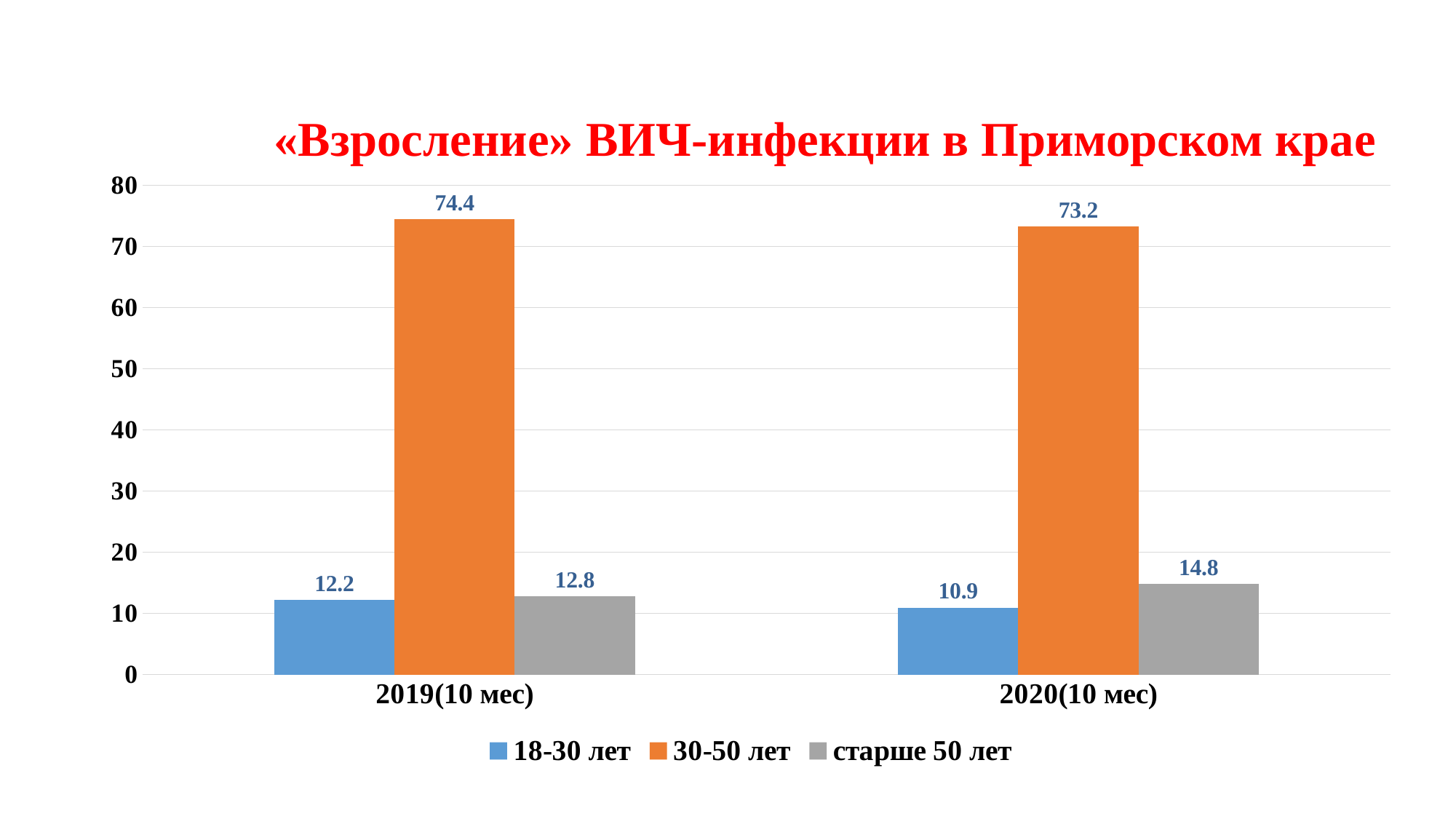
What is the value for the 30-50 лет series in 2019(10 мес)? 74.4 Which series has the highest value in 2020(10 мес)? 30-50 лет What is the title of the chart? «Взросление» ВИЧ-инфекции в Приморском крае What is the value for the старше 50 лет series in 2020(10 мес)? 14.8 What is the value for the 18-30 лет series in 2020(10 мес)? 10.9 Which series has the lowest value in 2019(10 мес)? 18-30 лет Which is larger: the старше 50 лет value in 2019(10 мес) or in 2020(10 мес)? 2020(10 мес) How many series does the legend list? 3 What kind of chart is shown on the slide? Bar chart Is the value for 30-50 лет in 2019(10 мес) greater or less than 70? greater What is the difference between the 30-50 лет values for 2019(10 мес) and 2020(10 мес)? 1.2 What is the value for the старше 50 лет series in 2019(10 мес)? 12.8